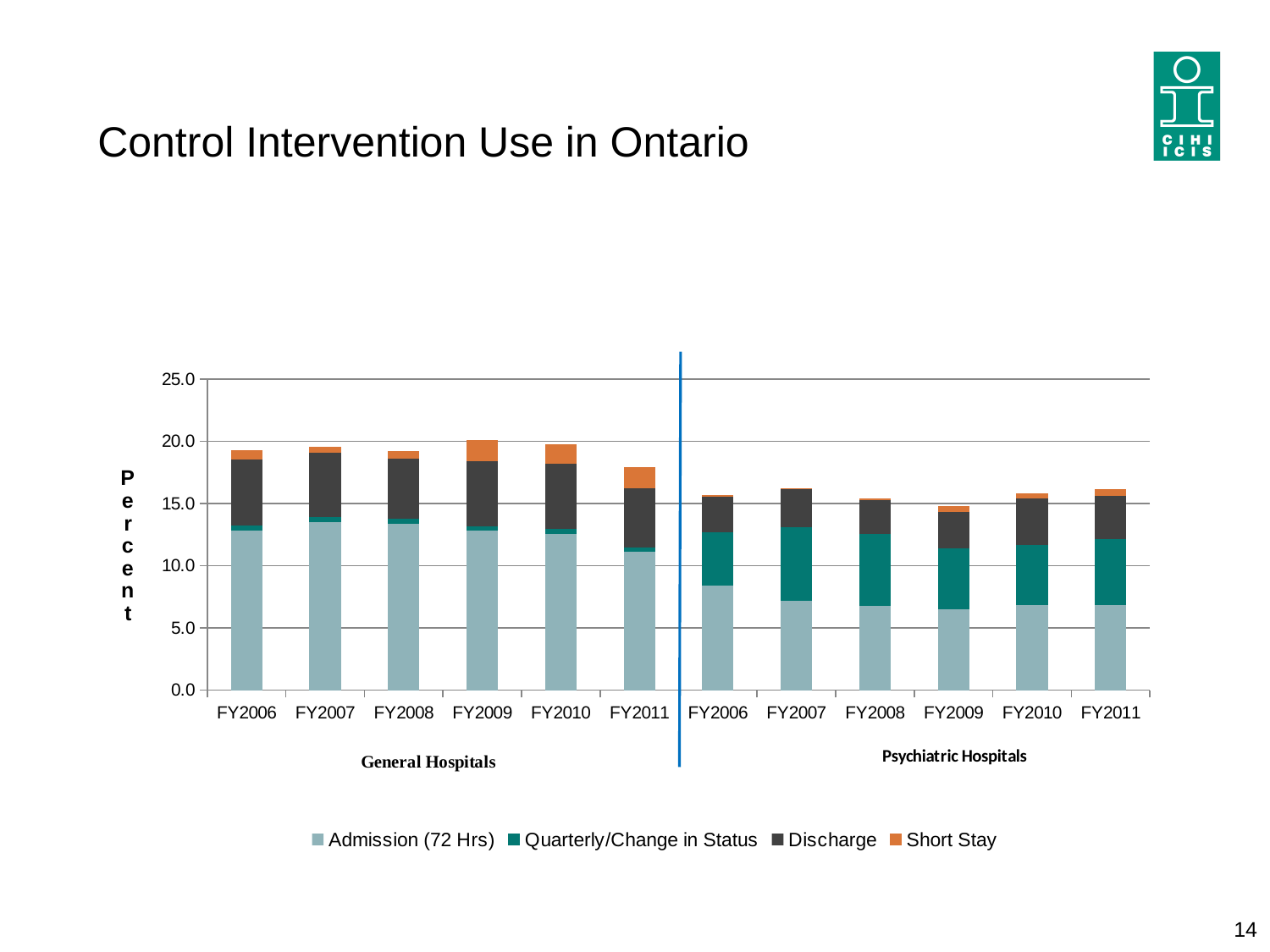
What is the title of the slide's chart? Control Intervention Use in Ontario Which fiscal year has the lowest total bar among General Hospitals? FY2011 Which is larger, the total for FY2006 in General Hospitals or the total for FY2006 in Psychiatric Hospitals? FY2006 in General Hospitals Is the Admission (72 Hrs) value for FY2006 in General Hospitals greater or less than 10.0? greater Is the total for FY2007 in Psychiatric Hospitals greater or less than 15.0? greater Is the total for FY2011 in General Hospitals greater or less than 20.0? less Which legend entry is shown in orange? Short Stay How many bars are plotted in the chart? 12 How many series does the legend list? 4 What kind of chart is shown on the slide? Stacked bar chart Does the total bar for General Hospitals rise or fall from FY2010 to FY2011? fall